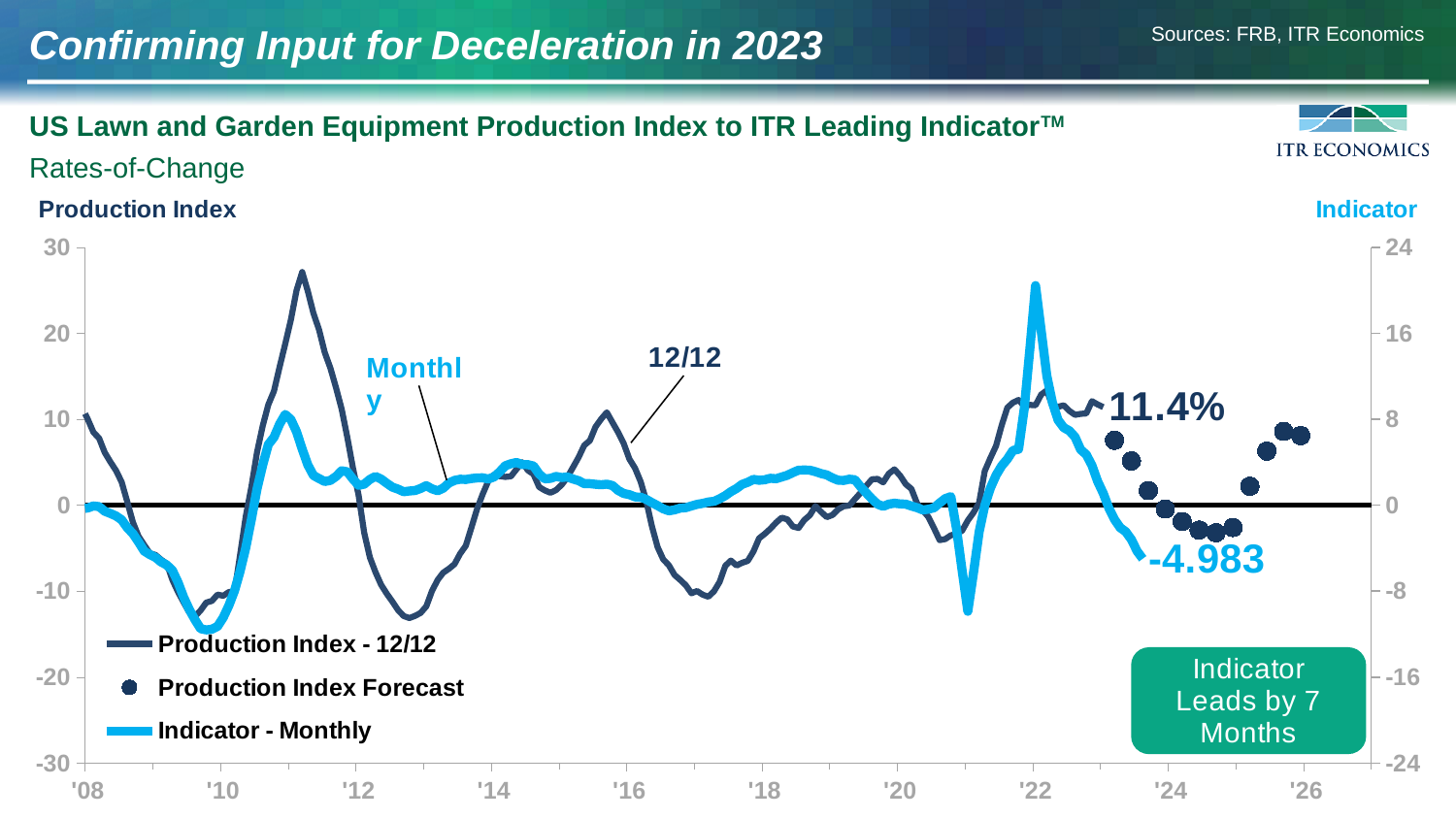
How many series does the legend list? 3 What is the latest labeled value of the Indicator - Monthly line? -4.983 What is the first year label on the x axis? '08 What is the latest labeled value of the Production Index - 12/12 line? 11.4% Which is larger, the latest labeled Production Index 12/12 value or the latest labeled Indicator Monthly value? Production Index 12/12 (11.4%) Is the Indicator - Monthly value at its 2022 peak greater or less than 16 on the right-hand axis? greater Does the Production Index - 12/12 line rise or fall between 2022 and 2023? Fall Is the Indicator - Monthly value at its 2021 trough greater or less than -8 on the right-hand axis? less What kind of chart is shown on the slide? Line chart Is the Production Index - 12/12 value at its 2011 peak greater or less than 20 on the left-hand axis? greater What is the title of the chart? US Lawn and Garden Equipment Production Index to ITR Leading Indicator By how many months does the Indicator lead, according to the callout box? 7 Months